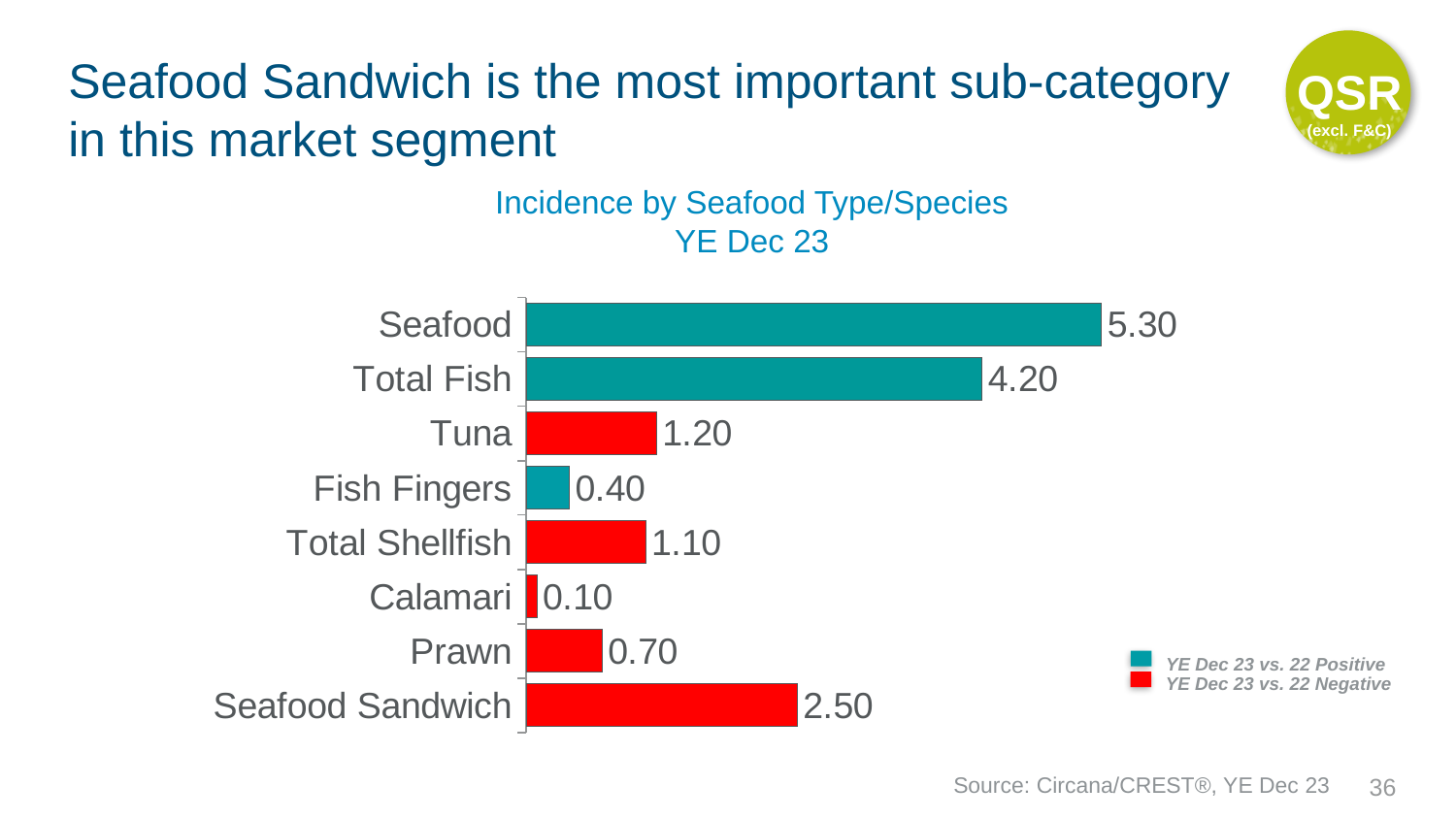
What kind of chart is shown on the slide? Bar chart What is the difference between the values for Tuna and Prawn? 0.50 What is the value for Fish Fingers? 0.40 What is the difference between the values for Seafood and Total Fish? 1.10 What is the value for Total Fish? 4.20 Which is larger, the value for Tuna or the value for Total Shellfish? Tuna Which category has the lowest value? Calamari What colour are the bars for categories that are negative YE Dec 23 vs. 22? Red What is the value for Seafood Sandwich? 2.50 How many categories are shown in the chart? 8 How many series does the legend list? 2 Which category has the highest value? Seafood